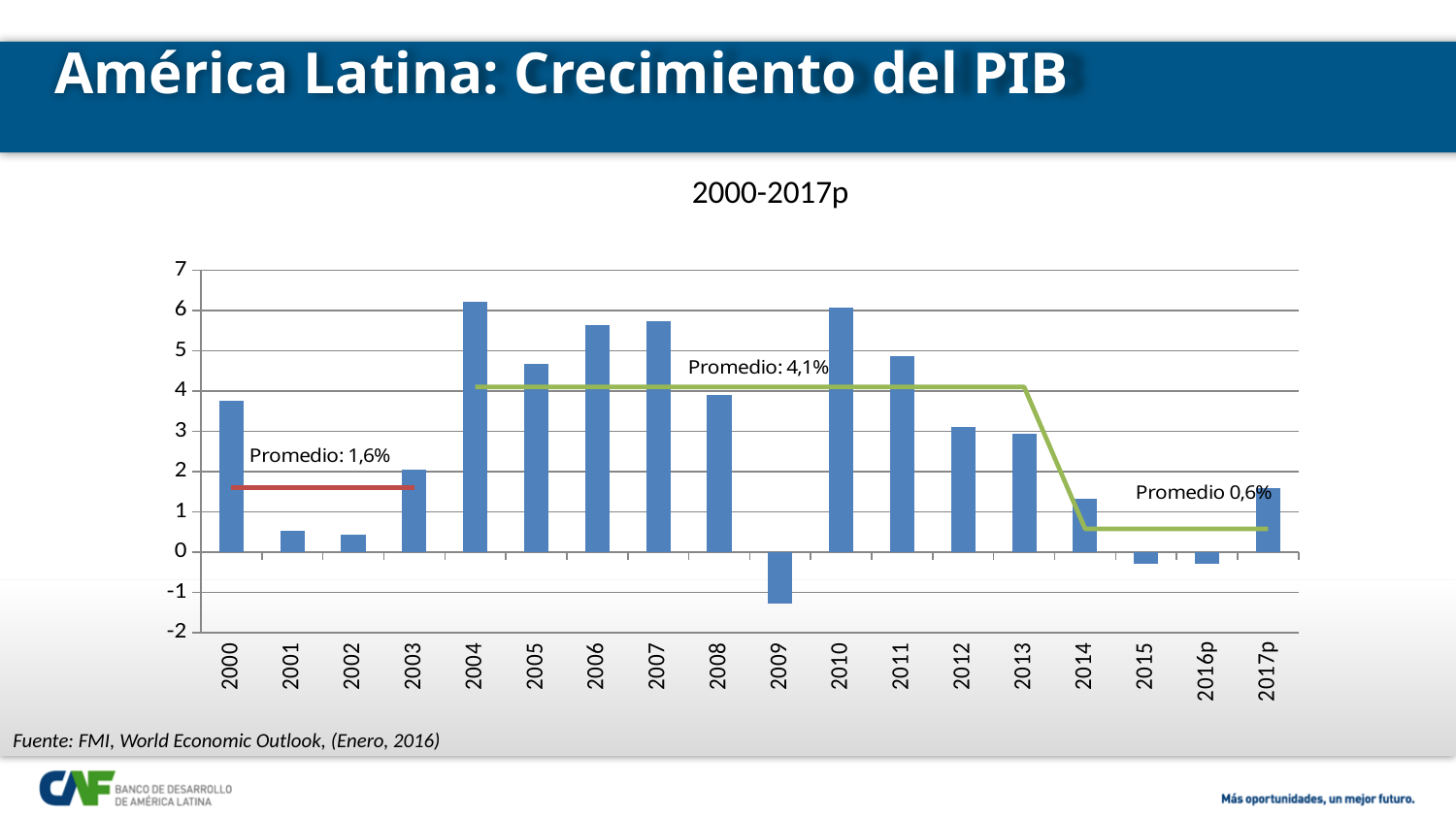
Is the value for 2011 greater or less than 4? greater Which year has the lowest GDP growth value? 2009 Is the value for 2009 greater or less than 0? less How many years (categories) are plotted on the x axis? 18 Do the values rise or fall from 2010 to 2015? fall What kind of chart is shown on the slide? bar chart Is the value for 2001 greater or less than 1? less Which year has the larger value, 2003 or 2004? 2004 Which year has the larger value, 2009 or 2015? 2015 What average (Promedio) is annotated for the period 2004-2013? 4,1%